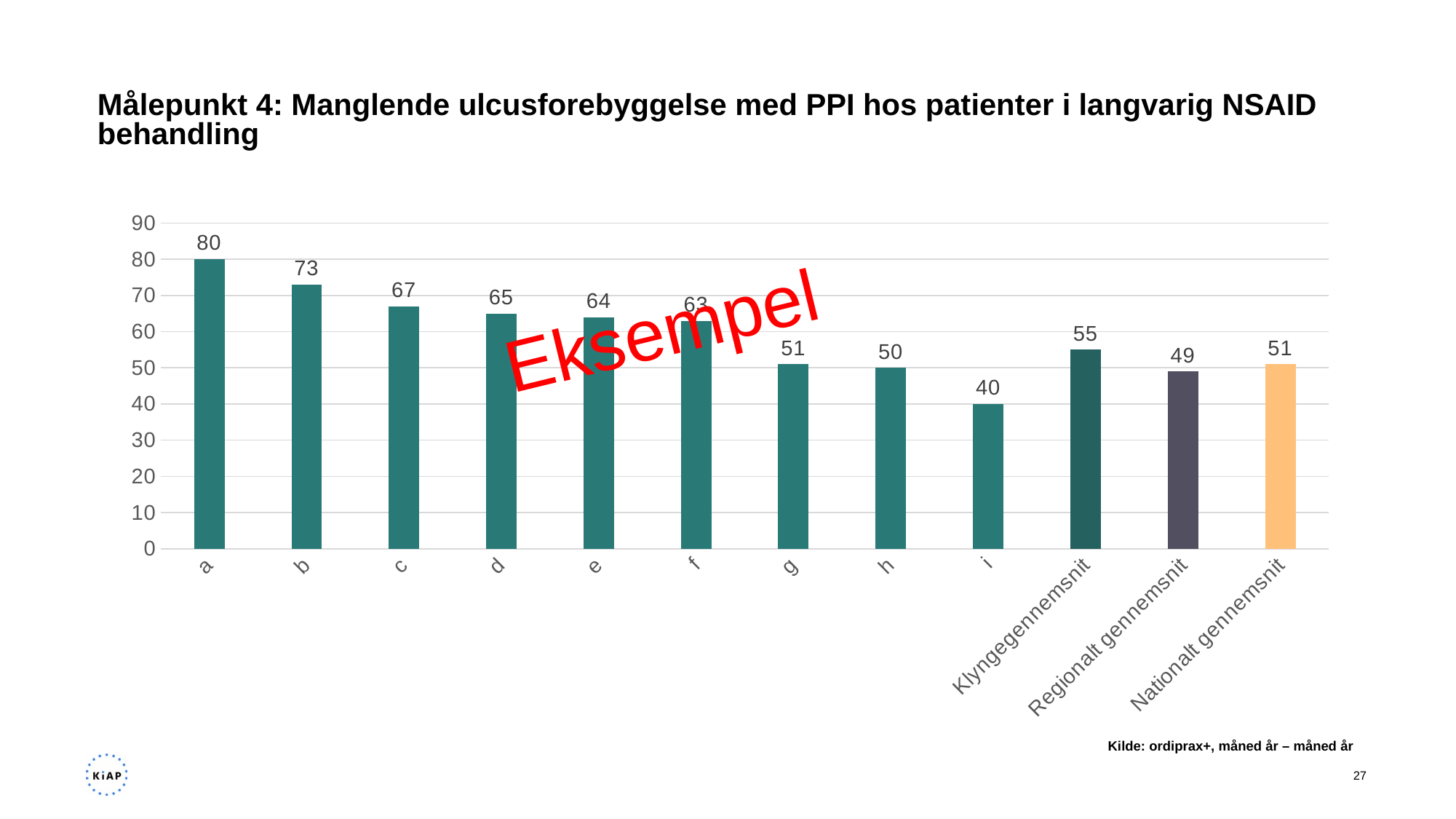
Do the values for categories a through i rise or fall from left to right? Fall What is the difference between the values for b and c? 6 What is the value for category a? 80 What is the value for Regionalt gennemsnit? 49 Which category has the highest value? a What is the value for Klyngegennemsnit? 55 What kind of chart is shown on the slide? Bar chart Which is larger, the value for Klyngegennemsnit or the value for Regionalt gennemsnit? Klyngegennemsnit Which category has the lowest value? i How many bars are shown in the chart? 12 What is the difference between the values for a and i? 40 What is the value for Nationalt gennemsnit? 51